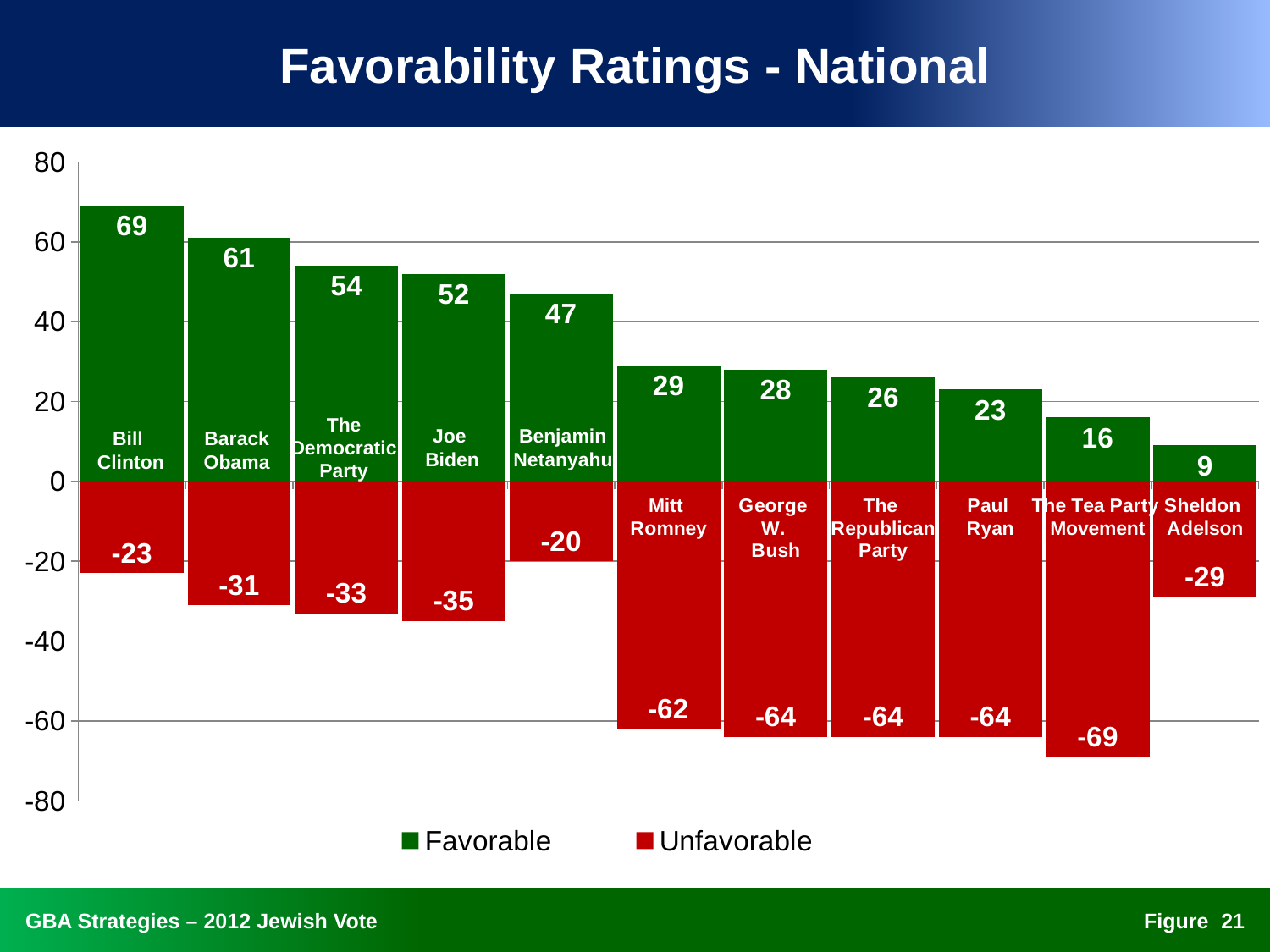
What is the difference between the Favorable values for Barack Obama and Mitt Romney? 32 Which has a higher Favorable value, Joe Biden or Paul Ryan? Joe Biden What is the Favorable value for Sheldon Adelson? 9 How many categories are shown on the x axis? 11 What is the Favorable value for Bill Clinton? 69 Which category has the highest Favorable value? Bill Clinton What is the title of the chart? Favorability Ratings - National How many series does the legend list? 2 Which category has the lowest Favorable value? Sheldon Adelson What is the Unfavorable value for The Tea Party Movement? -69 What kind of chart is shown on the slide? Bar chart What is the Unfavorable value for Benjamin Netanyahu? -20